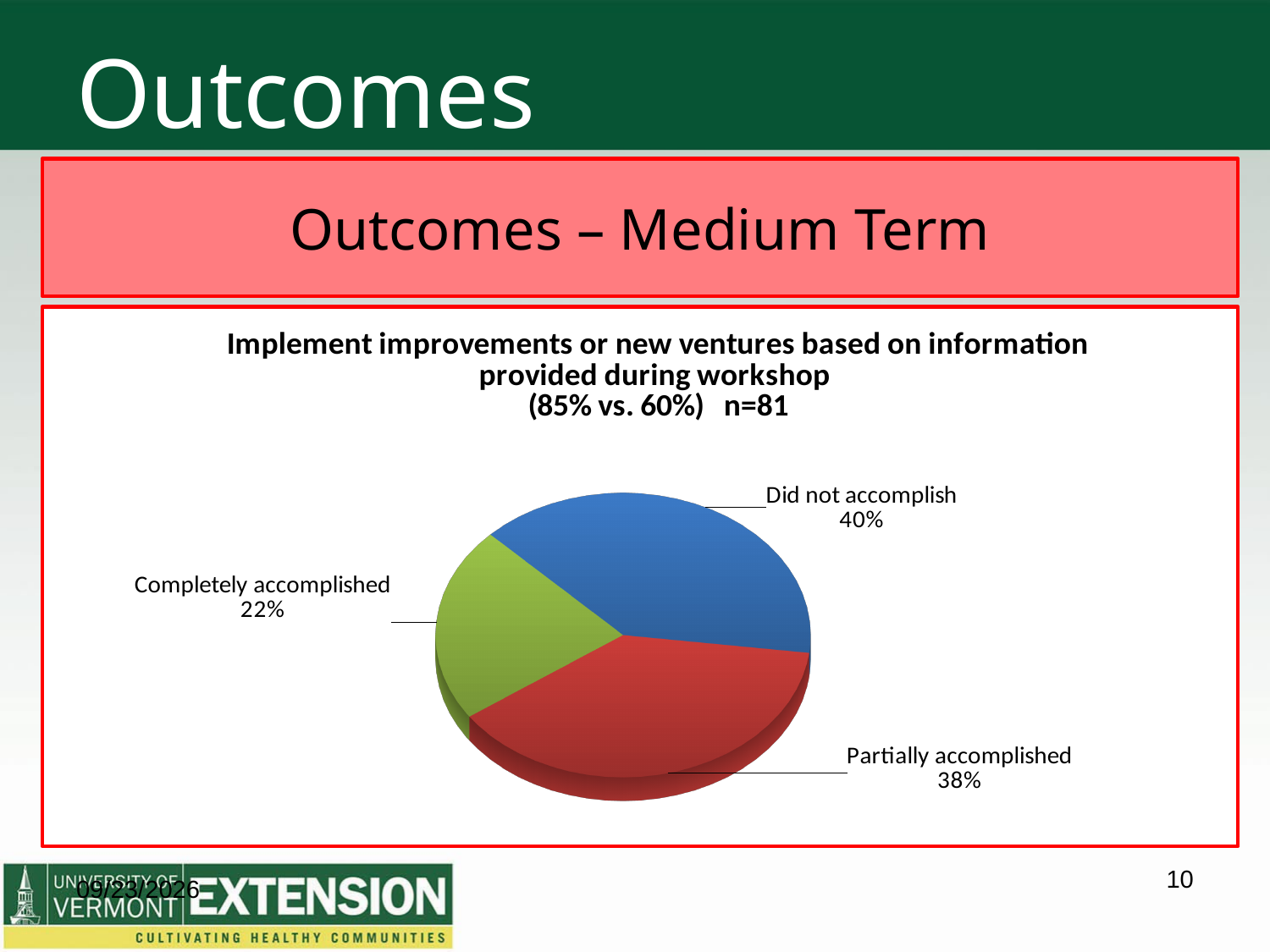
What is the difference in percentage points between 'Partially accomplished' and 'Completely accomplished'? 16 Which category has the smallest slice of the pie? Completely accomplished What share of the pie is labelled 'Partially accomplished'? 38% What percentage of respondents completely accomplished implementing improvements or new ventures? 22% What is the sample size (n) stated in the chart title? n=81 What is the combined percentage of respondents who partially or completely accomplished the outcome? 60% Which category has the largest slice of the pie? Did not accomplish What colour is the 'Completely accomplished' slice? Green Which is larger: the 'Did not accomplish' slice or the 'Completely accomplished' slice? Did not accomplish How many slices does the pie chart have? 3 What type of chart is shown on the slide? Pie chart What percentage of respondents did not accomplish implementing improvements or new ventures? 40%